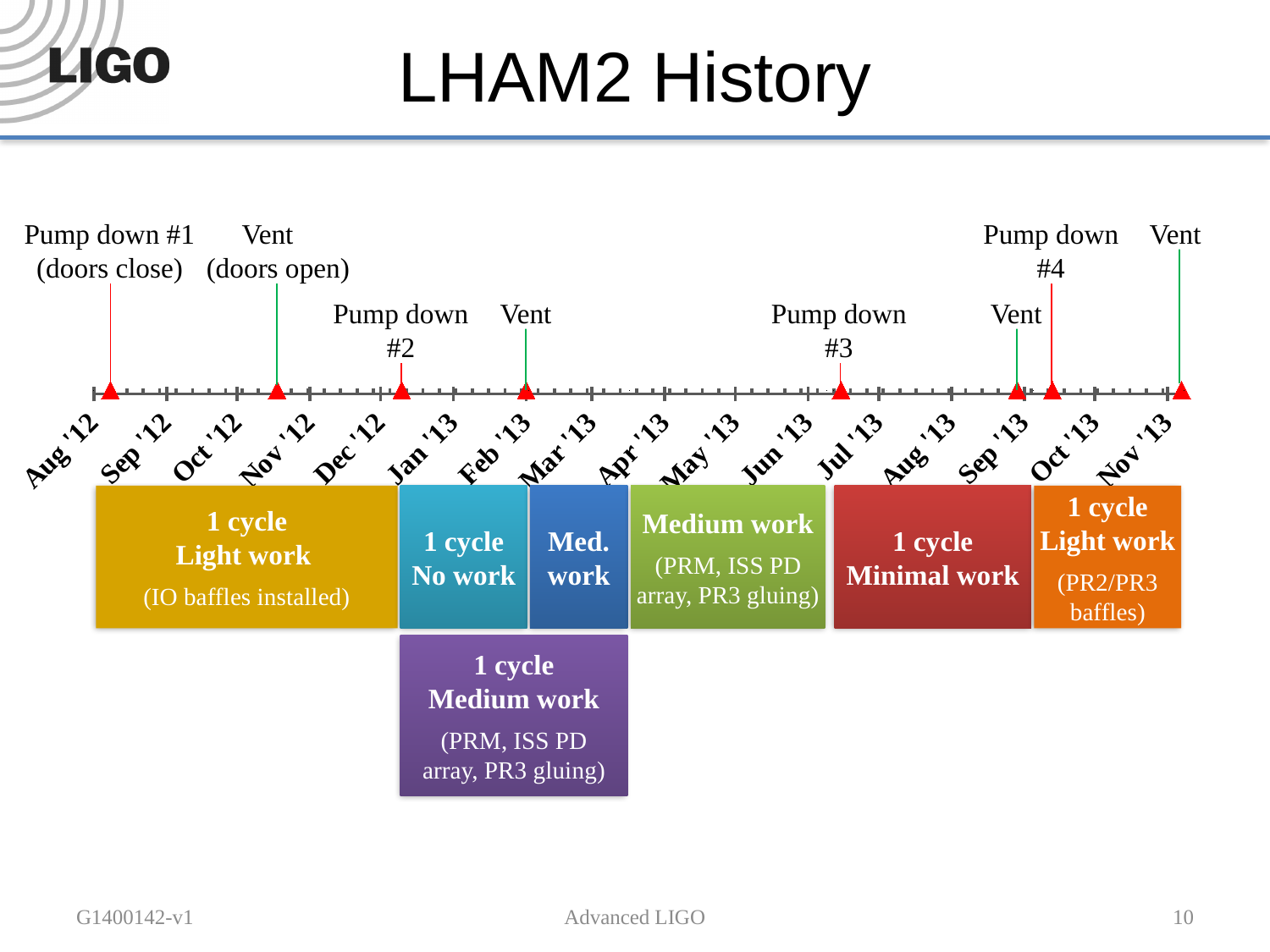
How many pump down events are marked on the timeline? 4 What is the last month label on the timeline axis? Nov '13 What is the first month label on the timeline axis? Aug '12 What work level is listed for the red box covering Jul '13 to Sep '13? 1 cycle Minimal work Which pump down event is annotated with "(doors close)"? Pump down #1 How many vent events are marked on the timeline? 4 What work is listed for the first cycle (the yellow box starting at Aug '12)? Light work (IO baffles installed) What is the title of the timeline chart? LHAM2 History How many month labels appear along the timeline axis? 16 What kind of chart is shown on the slide? Timeline What work is listed for the last cycle (the orange box ending at Nov '13)? Light work (PR2/PR3 baffles) What colour is the box labelled "1 cycle No work"? Teal/blue